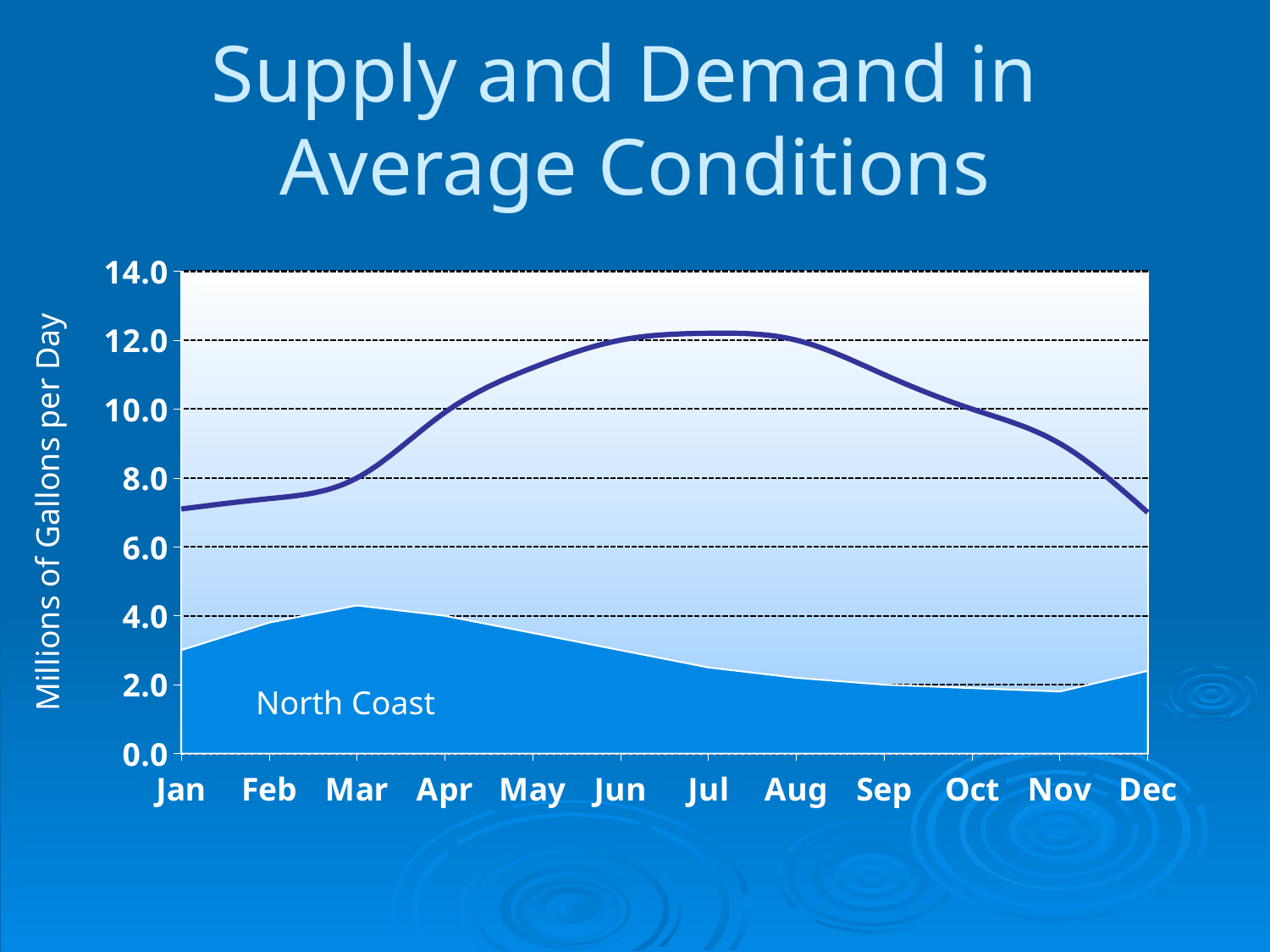
What kind of chart is shown on the slide? A line chart with a shaded area series Is the value of the dark line in Jan greater or less than 8.0? less What is the label shown inside the shaded area series? North Coast Is the value of the dark line in Jul greater or less than 10.0? greater In which month does the North Coast shaded area reach its highest value? Mar Is the value of the dark line in Nov greater or less than 8.0? greater In Jul, which is larger: the dark line or the North Coast shaded area? The dark line Does the dark line rise or fall from Jan to Jul? rise What is the label on the y axis? Millions of Gallons per Day How many months are shown along the x axis? 12 In which month does the dark line reach its highest value? Jul